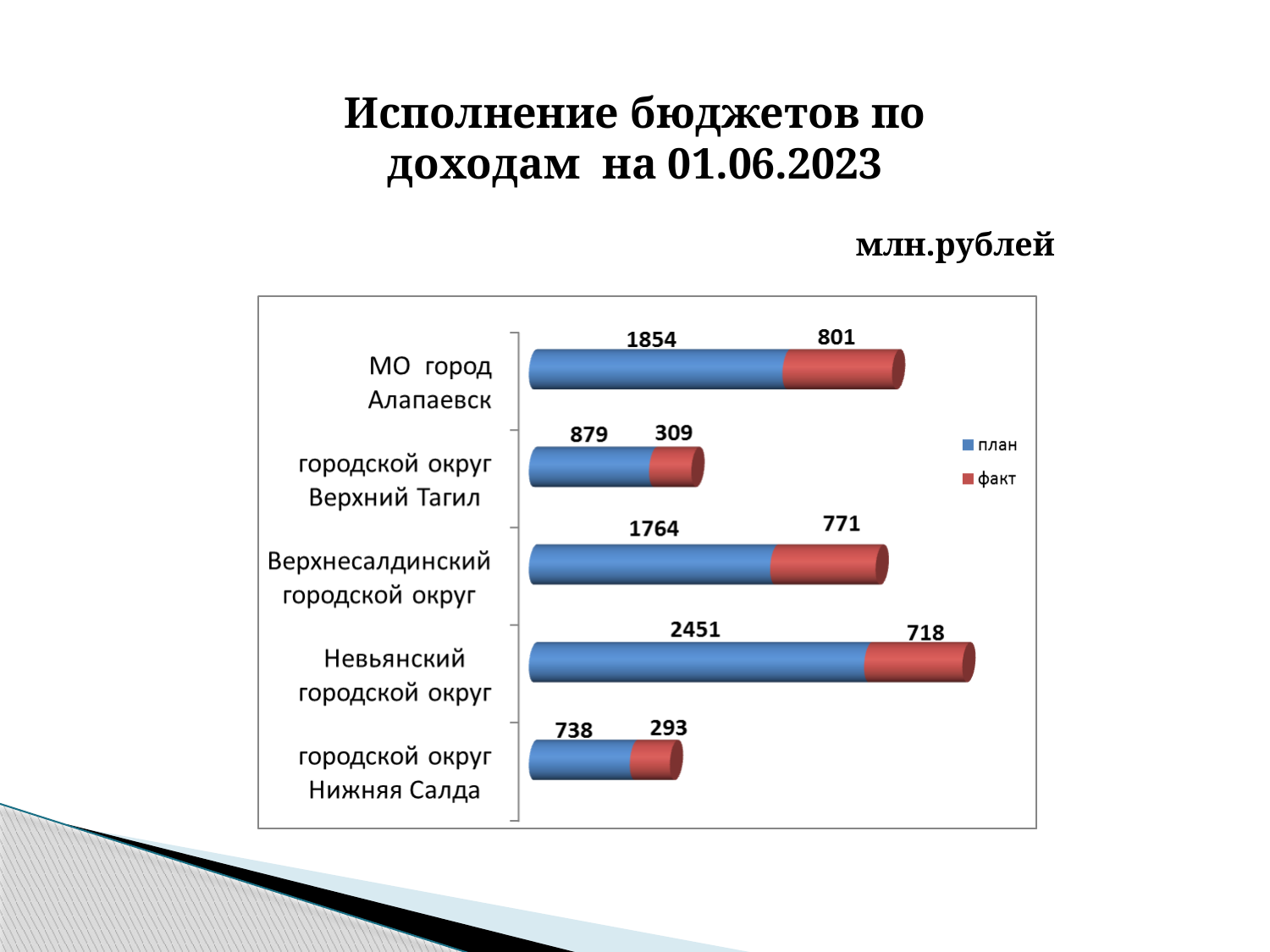
What is the total of the stacked bar for городской округ Нижняя Салда? 1031 What is the факт value for городской округ Верхний Тагил? 309 How many series does the legend list? 2 What is the план value for Невьянский городской округ? 2451 How many categories are shown on the chart? 5 Which category has the lowest факт value? городской округ Нижняя Салда Which category has the highest план value? Невьянский городской округ What is the план value for МО город Алапаевск? 1854 What is the difference between the план and факт values for Верхнесалдинский городской округ? 993 Which colour represents the факт series in the legend? Red Which is larger: the факт value for МО город Алапаевск or the факт value for Невьянский городской округ? МО город Алапаевск What kind of chart is shown on the slide? Stacked bar chart